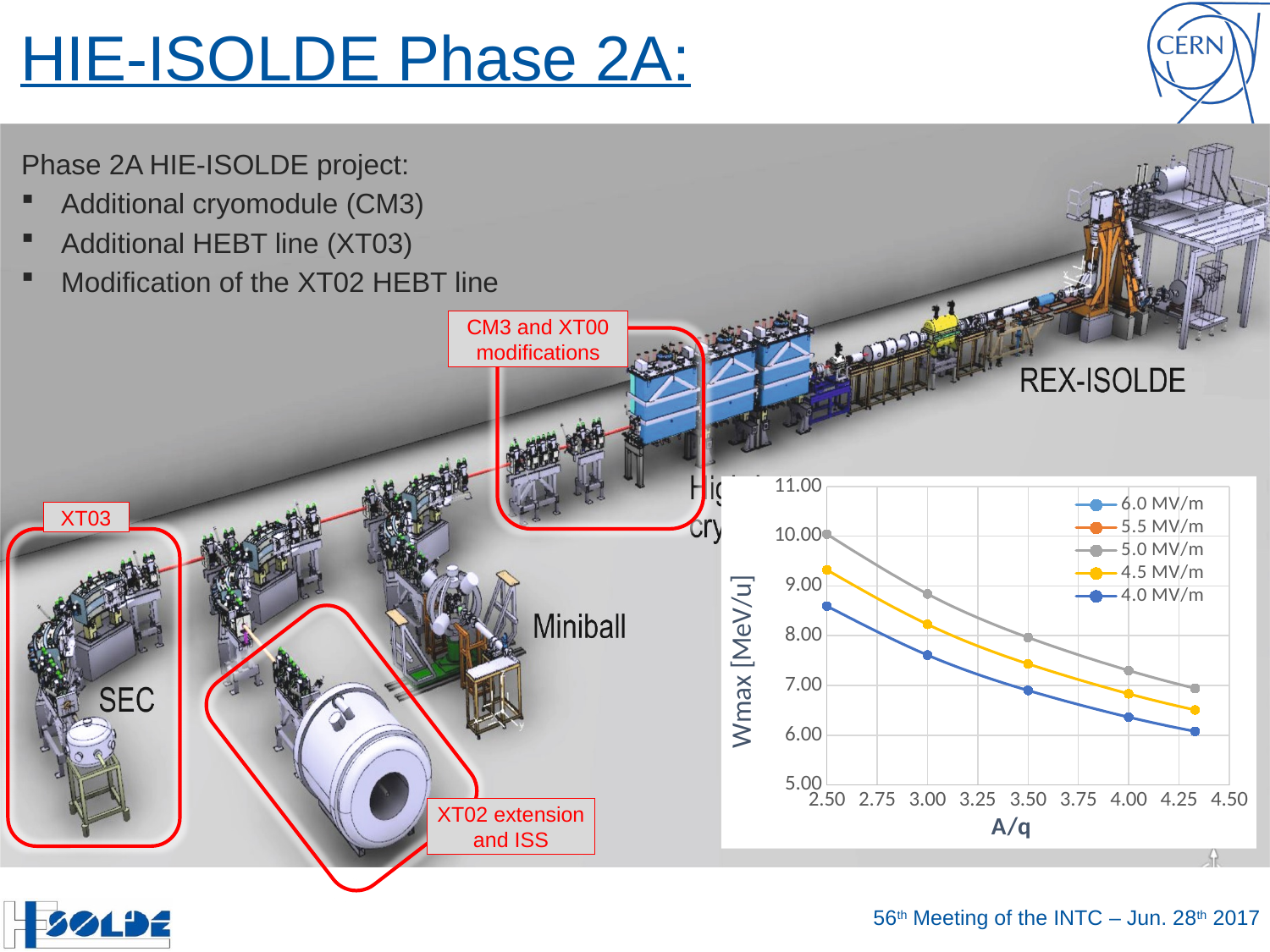
At A/q = 3.50, which line has the larger Wmax value, 5.0 MV/m or 4.0 MV/m? 5.0 MV/m What is the label of the chart's x axis? A/q Which of the plotted lines has the lowest Wmax values across the A/q range? 4.0 MV/m How many data points are plotted on the 4.0 MV/m line? 5 Is the value of the 4.0 MV/m line at A/q = 2.50 greater or less than 9.00? less How many series does the chart legend list? 5 Do the plotted Wmax values rise or fall as A/q increases? fall What is the label of the chart's y axis? Wmax [MeV/u] Is the value of the 4.5 MV/m line at A/q = 2.50 greater or less than 9.00? greater What kind of chart is shown on the slide? line chart Is the value of the 5.0 MV/m line at A/q = 3.00 greater or less than 8.00? greater